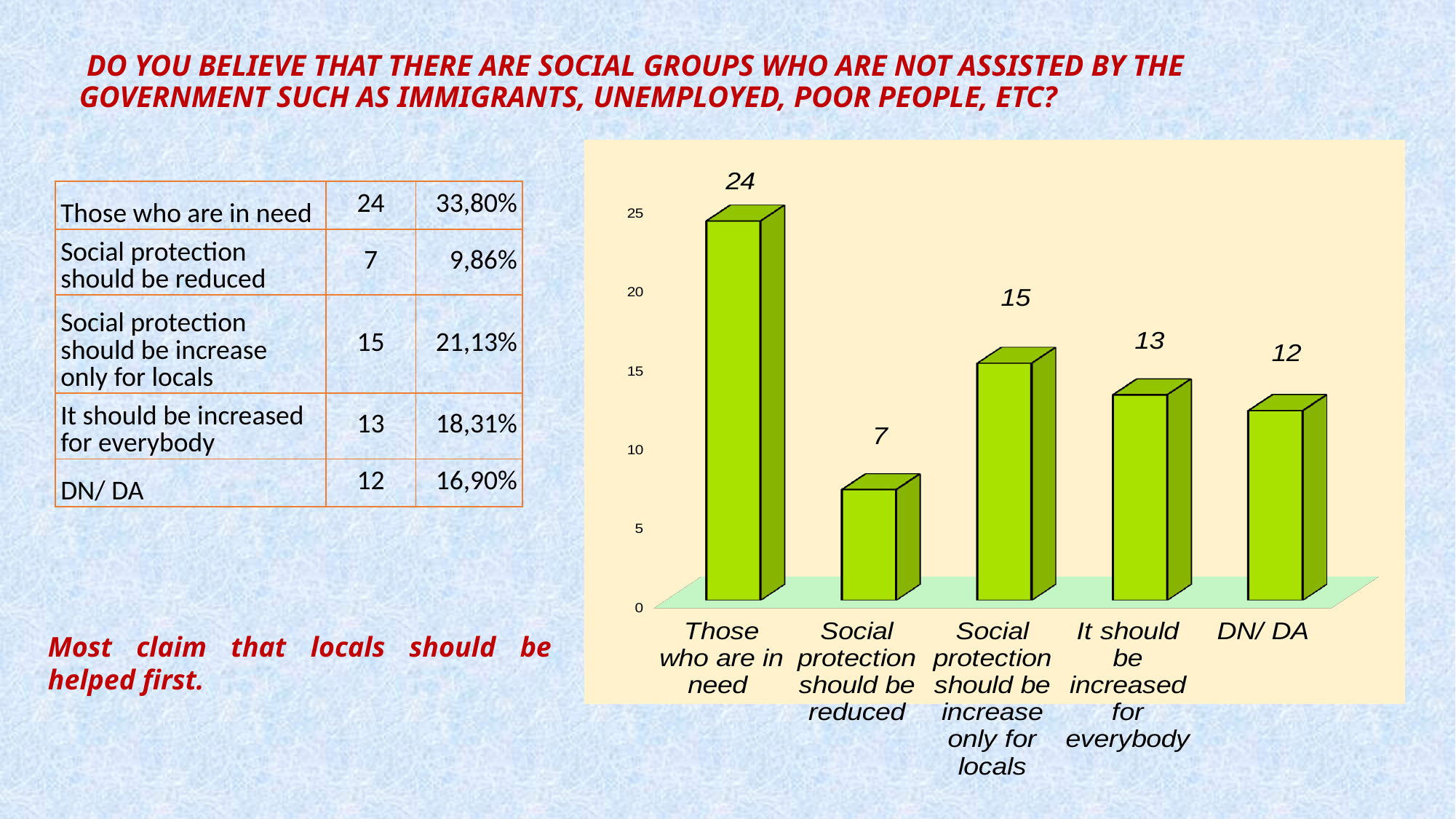
Is the value for "Social protection should be increase only for locals" greater or less than 10? greater What kind of chart is shown on the slide? bar chart What is the value for "It should be increased for everybody"? 13 Which category has the lowest value? Social protection should be reduced What is the value for "DN/ DA"? 12 What is the difference between the values for "Those who are in need" and "Social protection should be increase only for locals"? 9 What is the value for "Social protection should be reduced"? 7 Which category has the highest value? Those who are in need What is the value for "Those who are in need"? 24 How many categories are shown in the chart? 5 What colour are the bars in the chart? green Which is larger, the value for "It should be increased for everybody" or the value for "DN/ DA"? It should be increased for everybody